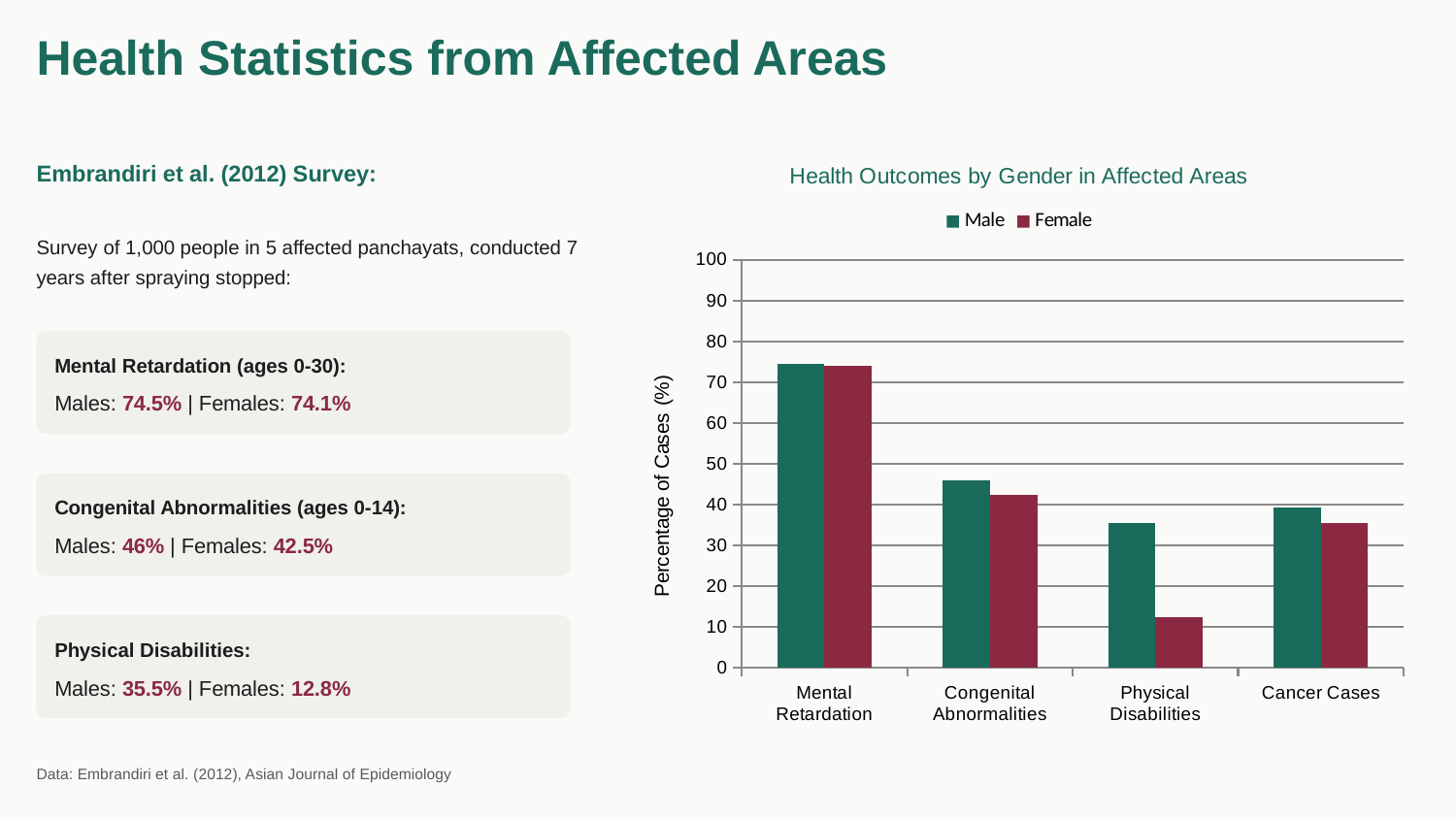
Which category has the highest Male value in the chart? Mental Retardation For Cancer Cases, which is larger: the Male value or the Female value? Male What is the Male value for Mental Retardation? 74.5% Which category has the lowest Female value in the chart? Physical Disabilities What is the title of the chart? Health Outcomes by Gender in Affected Areas What type of chart is shown on the slide? Bar chart How many series does the legend of the chart list? 2 How many categories are shown on the x axis of the chart? 4 What is the Female value for Physical Disabilities? 12.8% Is the Female value for Cancer Cases greater or less than 40? less Is the Male value for Cancer Cases greater or less than 30? greater What is the difference between the Male and Female values for Congenital Abnormalities? 3.5 percentage points